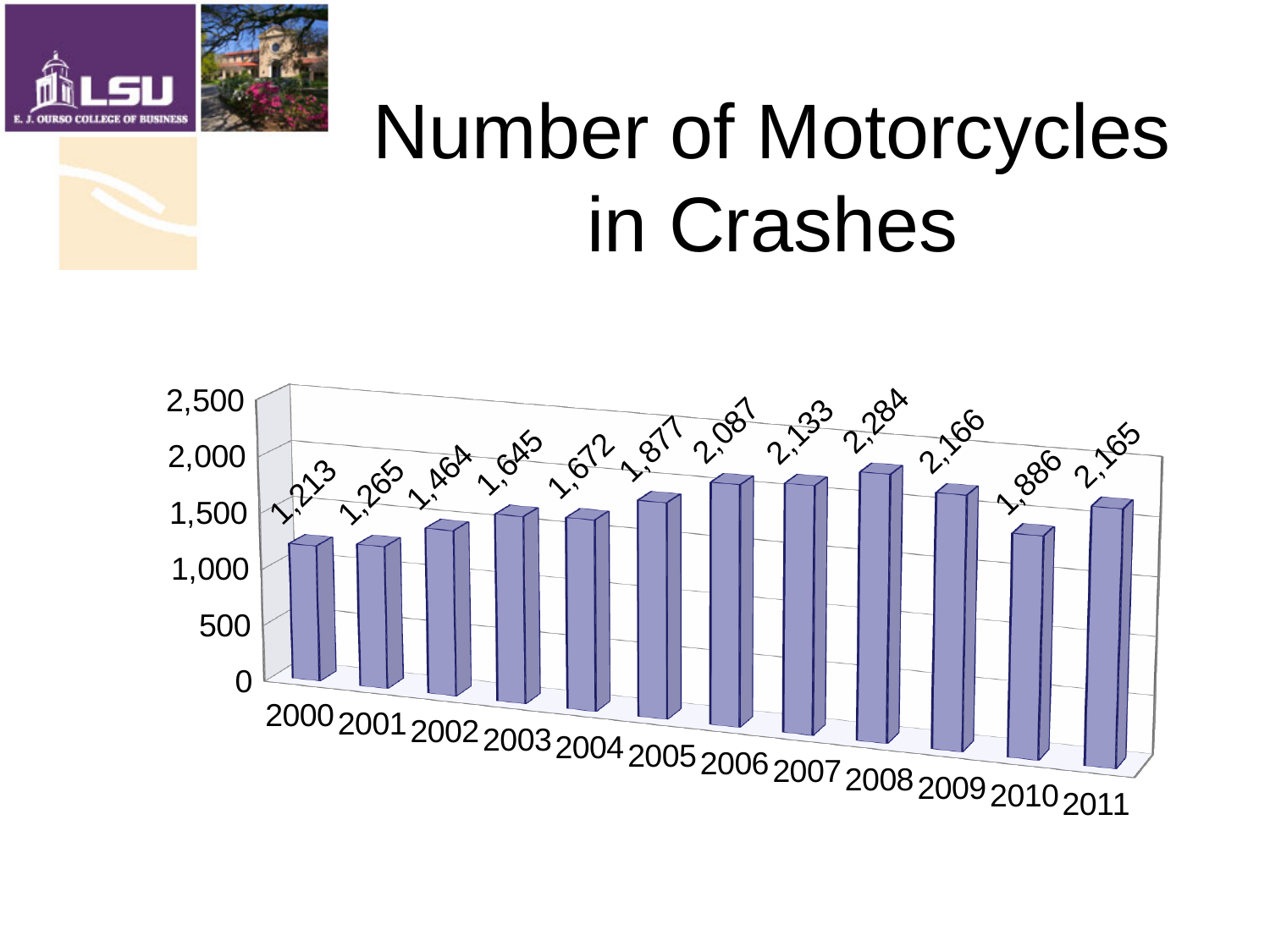
What is the difference between the number of motorcycles in crashes in 2008 and in 2000? 1,071 Is the value for 2005 greater or less than 2,000? less What is the number of motorcycles in crashes in 2011? 2,165 Which year has the highest number of motorcycles in crashes? 2008 What kind of chart is shown on the slide? bar chart How many years are shown on the chart? 12 Which year had more motorcycles in crashes, 2006 or 2010? 2006 What is the number of motorcycles in crashes in 2008? 2,284 What is the title of the chart on the slide? Number of Motorcycles in Crashes What is the number of motorcycles in crashes in 2000? 1,213 Which year has the lowest number of motorcycles in crashes? 2000 What is the difference between the number of motorcycles in crashes in 2010 and in 2009? 280